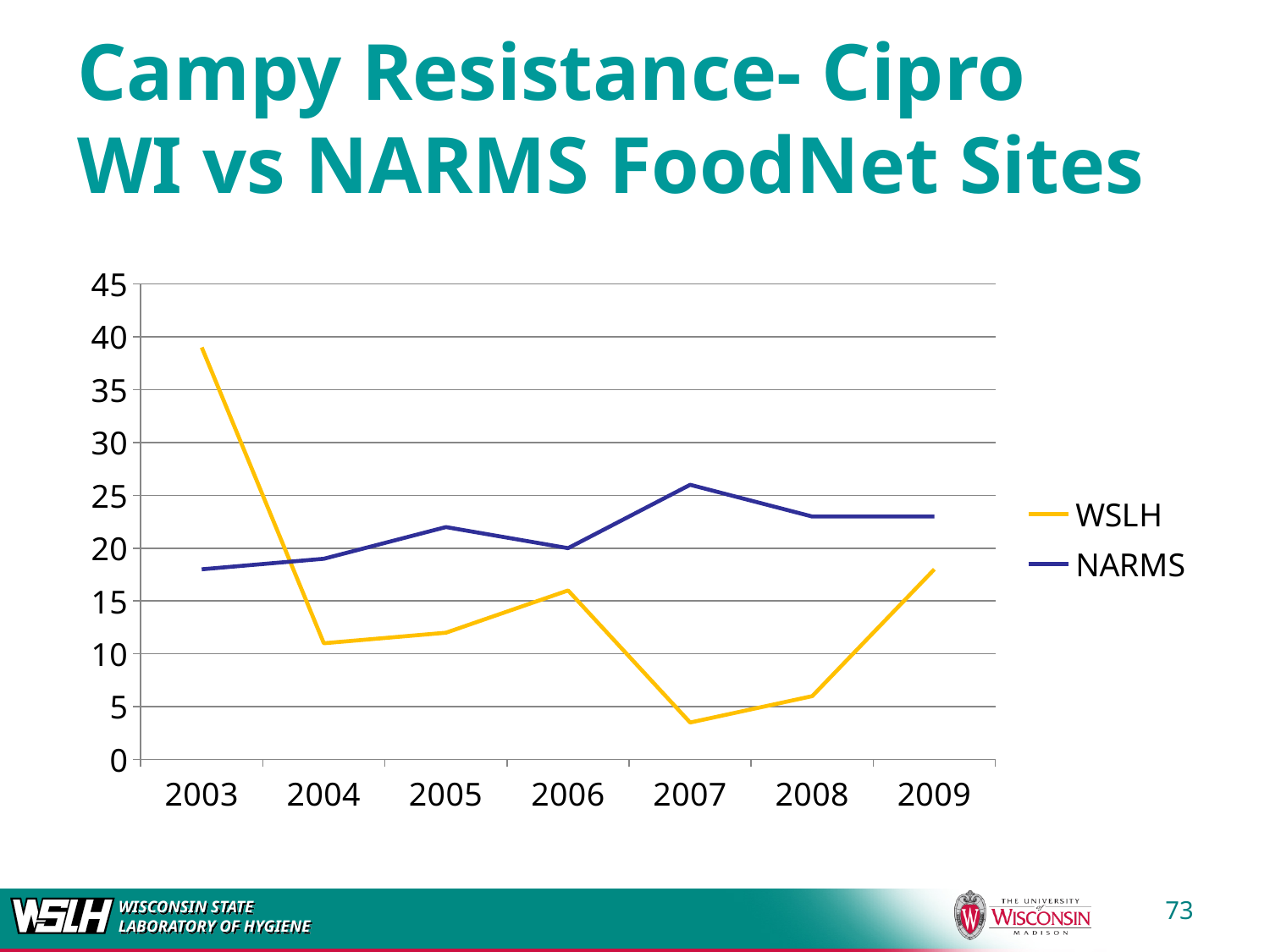
Which series is shown in yellow? WSLH Is the WSLH value for 2003 greater or less than 35? greater In which year is the NARMS value highest? 2007 Is the WSLH value for 2007 greater or less than 5? less How many series does the legend list? 2 In which year is the WSLH value lowest? 2007 In 2003, which series has the larger value, WSLH or NARMS? WSLH In which year is the WSLH value highest? 2003 In 2007, which series has the larger value, WSLH or NARMS? NARMS What kind of chart is shown on the slide? line chart How many years are shown on the x axis? 7 Does the WSLH line rise or fall from 2008 to 2009? rise